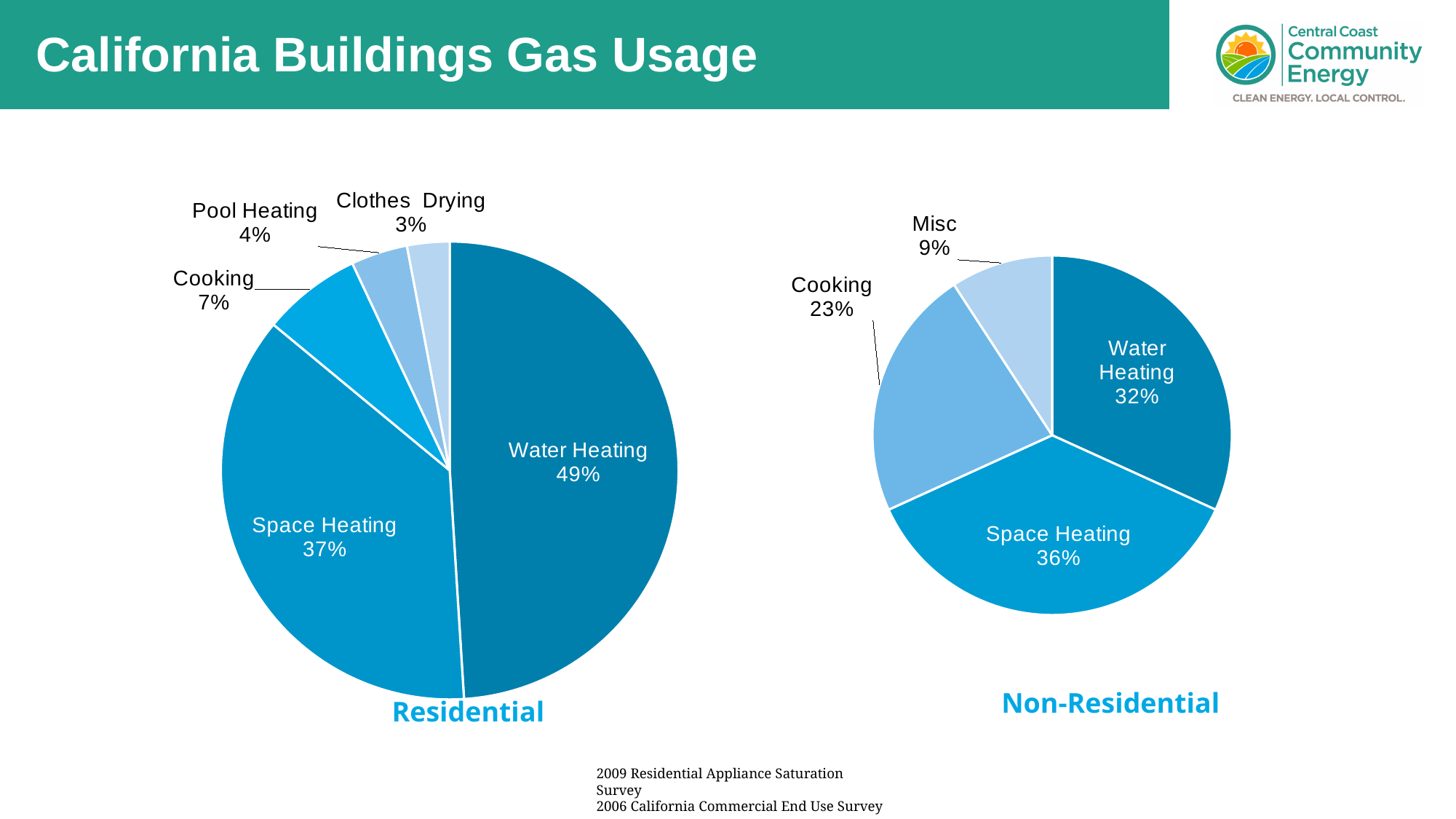
In the Residential pie chart, what is the difference between the Water Heating and Space Heating shares? 12 percentage points In the Residential pie chart, which category has the largest share? Water Heating In the Residential pie chart, what share does Water Heating have? 49% In the Residential pie chart, what share does Clothes Drying have? 3% In the Residential pie chart, what share does Space Heating have? 37% In the Non-Residential pie chart, what share does Cooking have? 23% In the Residential pie chart, which category has the smallest share? Clothes Drying In the Non-Residential pie chart, which category has the smallest share? Misc In the Non-Residential pie chart, what share does Misc have? 9% How many categories are shown in the Residential pie chart? 5 What type of chart is used for the Non-Residential data? Pie chart In the Non-Residential pie chart, which is larger, Cooking or Misc? Cooking